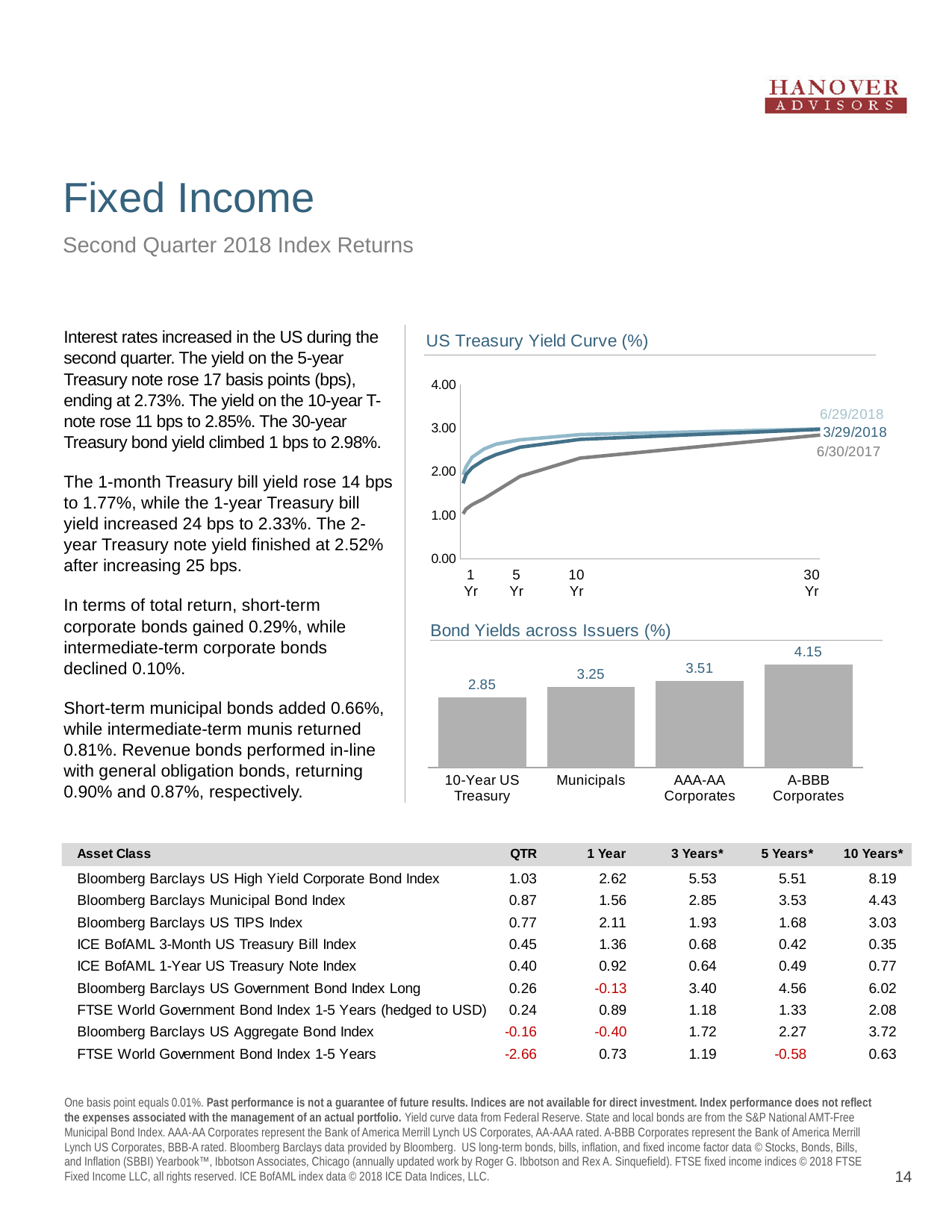
In the 'Bond Yields across Issuers (%)' chart, what is the value for A-BBB Corporates? 4.15 In the 'Bond Yields across Issuers (%)' chart, what is the difference between A-BBB Corporates and AAA-AA Corporates? 0.64 In the 'Bond Yields across Issuers (%)' chart, which is larger: Municipals or AAA-AA Corporates? AAA-AA Corporates In the 'Bond Yields across Issuers (%)' chart, what is the value for Municipals? 3.25 In the 'Bond Yields across Issuers (%)' chart, which category has the highest value? A-BBB Corporates In the 'US Treasury Yield Curve (%)' chart, is the 6/30/2017 value at 1 Yr greater or less than 2.00? less What kind of chart is 'Bond Yields across Issuers (%)'? Bar chart In the 'US Treasury Yield Curve (%)' chart, do the yields rise or fall as maturity increases from 1 Yr to 30 Yr? Rise How many series are shown in the 'US Treasury Yield Curve (%)' chart? 3 What kind of chart is 'US Treasury Yield Curve (%)'? Line chart How many bars are in the 'Bond Yields across Issuers (%)' chart? 4 In the 'Bond Yields across Issuers (%)' chart, which category has the lowest value? 10-Year US Treasury